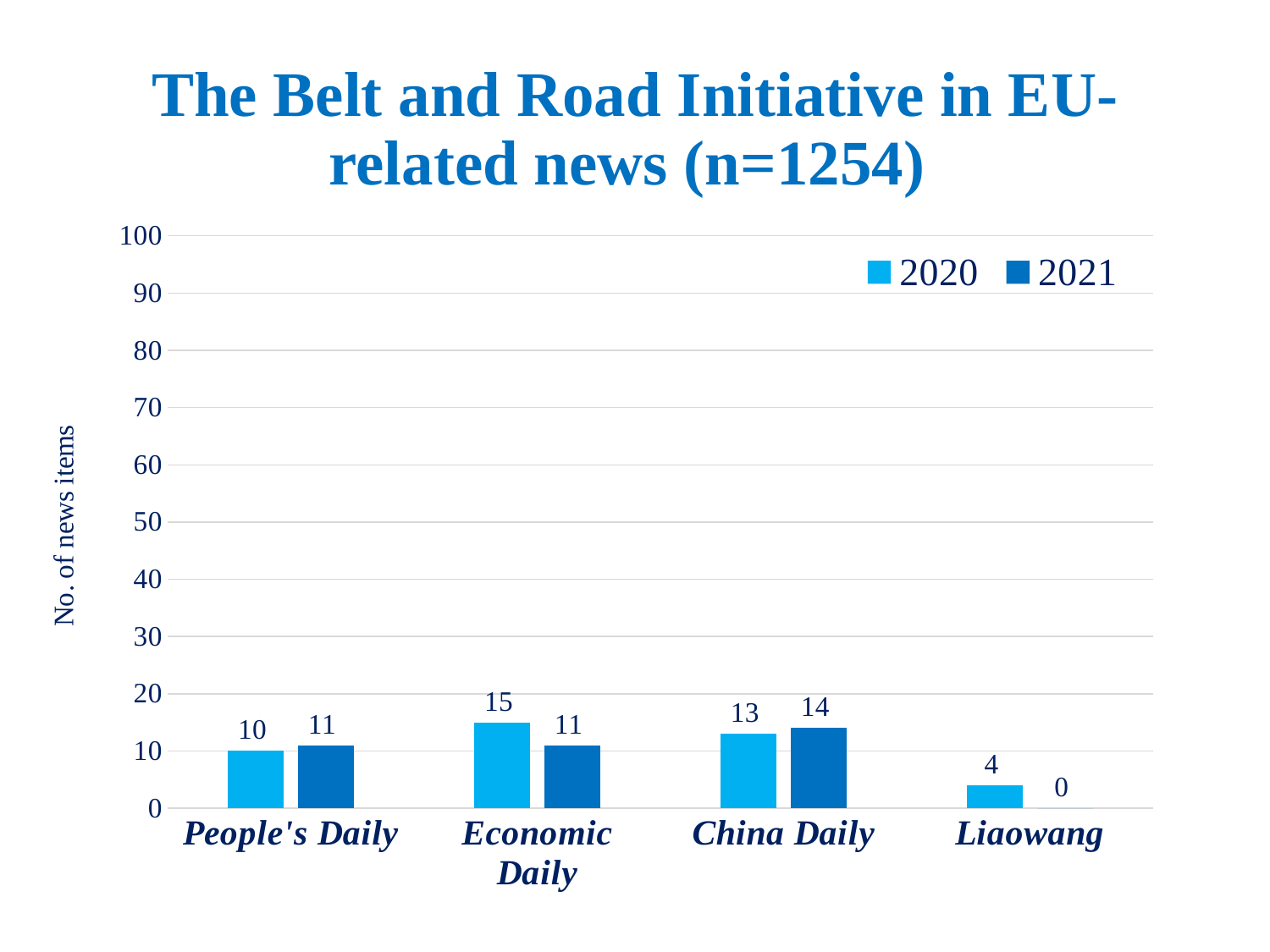
Is the value for Economic Daily in 2020 greater or less than 20? less What is the value for Liaowang in 2021? 0 What is the value for People's Daily in 2020? 10 Which outlet has the highest value in 2020? Economic Daily What is the difference between the 2020 and 2021 values for Economic Daily? 4 How many series does the legend list? 2 How many outlets are shown on the x axis? 4 What kind of chart is shown on the slide? bar chart What is the label of the vertical axis? No. of news items What is the value for Economic Daily in 2021? 11 Which outlet has the lowest value in 2021? Liaowang Which is larger for China Daily: the 2020 value or the 2021 value? 2021